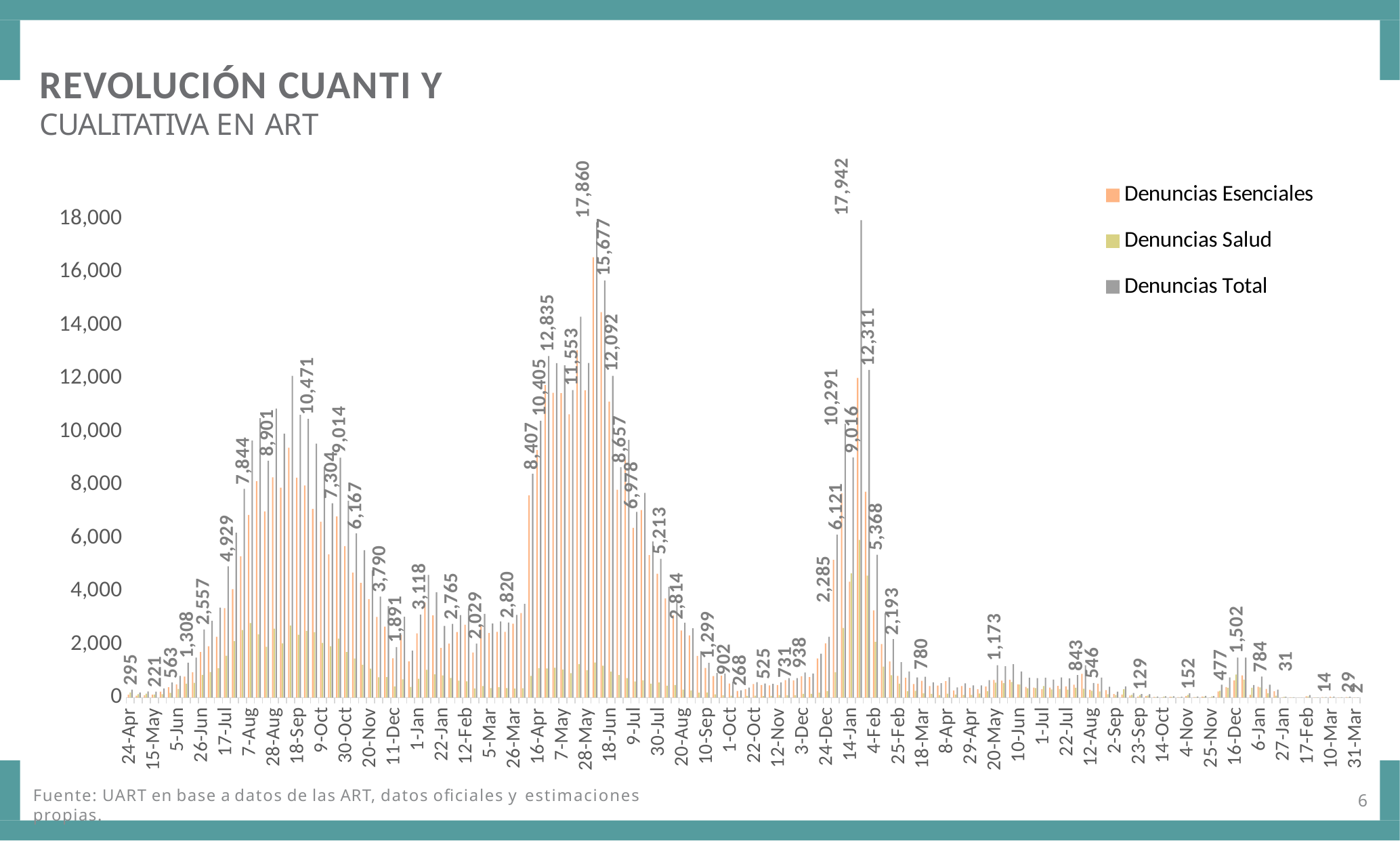
How many series does the legend list? 3 Which is larger, the peak labeled 17,942 or the peak labeled 17,860? 17,942 What is the data label on the first bar, at 24-Apr? 295 What kind of chart is shown on the slide? bar chart What is the difference between the labeled values 10,471 and 8,901? 1,570 What is the difference between the peaks labeled 17,942 and 17,860? 82 Is the tallest bar on the chart greater or less than 16,000? greater What is the highest data label printed on the chart? 17,942 What are the three series named in the legend? Denuncias Esenciales, Denuncias Salud, Denuncias Total What is the highest tick value shown on the y axis? 18,000 Which series is drawn in gray? Denuncias Total